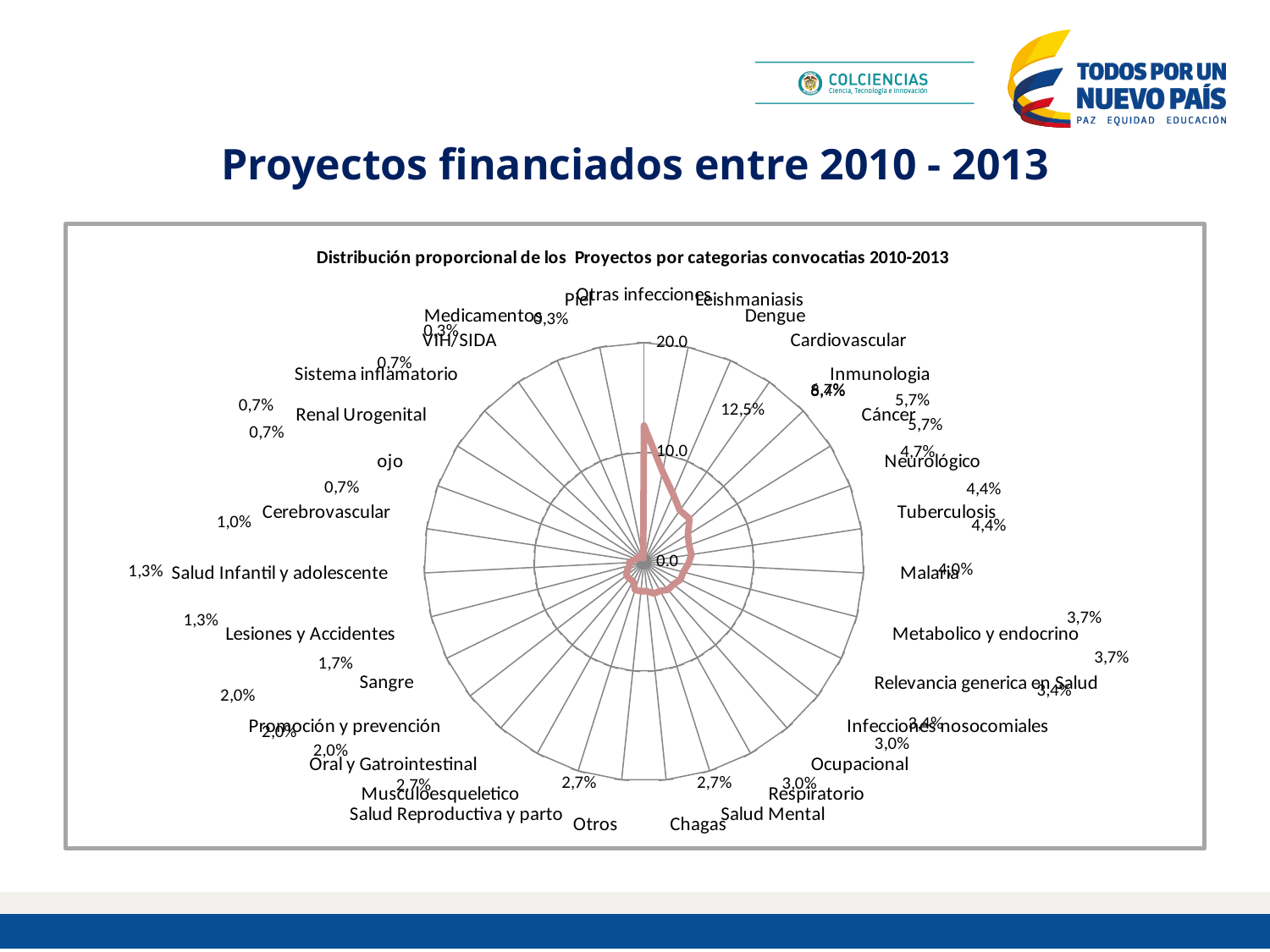
What is the value for Malaria? 4,0% What kind of chart is shown on the slide? Radar chart What is the value for Ocupacional? 3,4% Which is larger, the value for Cáncer or the value for Malaria? Cáncer What is the value for Cerebrovascular? 1,0% What is the title of the chart? Distribución proporcional de los Proyectos por categorias convocatias 2010-2013 What is the value for Cáncer? 4,7% What is the smallest data value labelled on the chart? 0,3% What is the largest data value labelled on the chart? 12,5% What is the highest value shown on the chart's radial axis? 20.0 What is the value for Neurológico? 4,4% What is the difference between the values for Cáncer and Neurológico? 0,3%